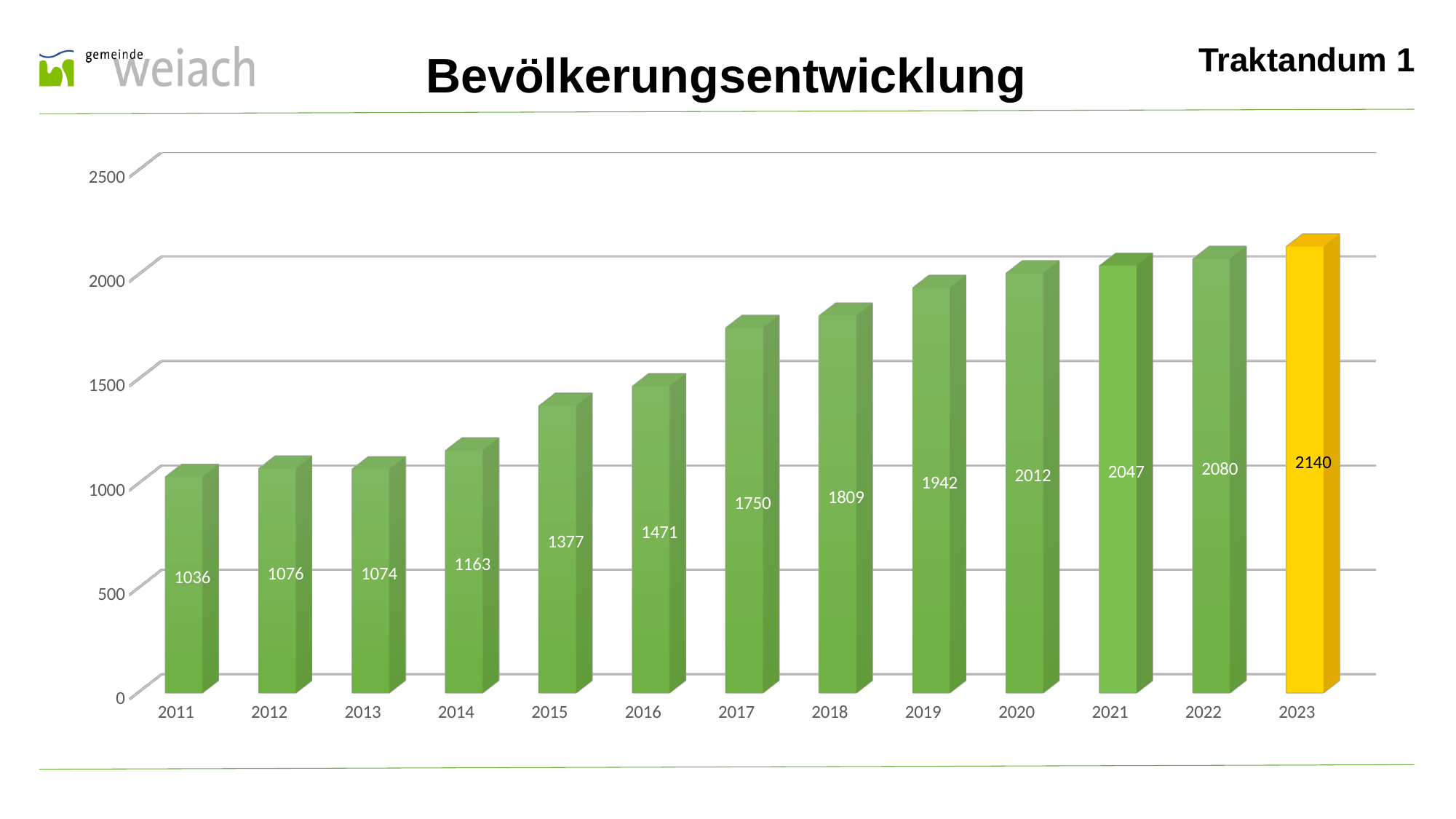
Which year has the highest value? 2023 Is the value for 2019 greater or less than 2000? less What is the value for 2023? 2140 Do the values generally rise or fall from 2011 to 2023? rise Which is larger, the value for 2012 or the value for 2013? 2012 What is the difference between the values for 2023 and 2011? 1104 What is the value for 2011? 1036 What kind of chart is shown on the slide? bar chart What is the value for 2017? 1750 What is the difference between the values for 2016 and 2015? 94 Which year has the lowest value? 2011 How many years are shown on the x axis? 13